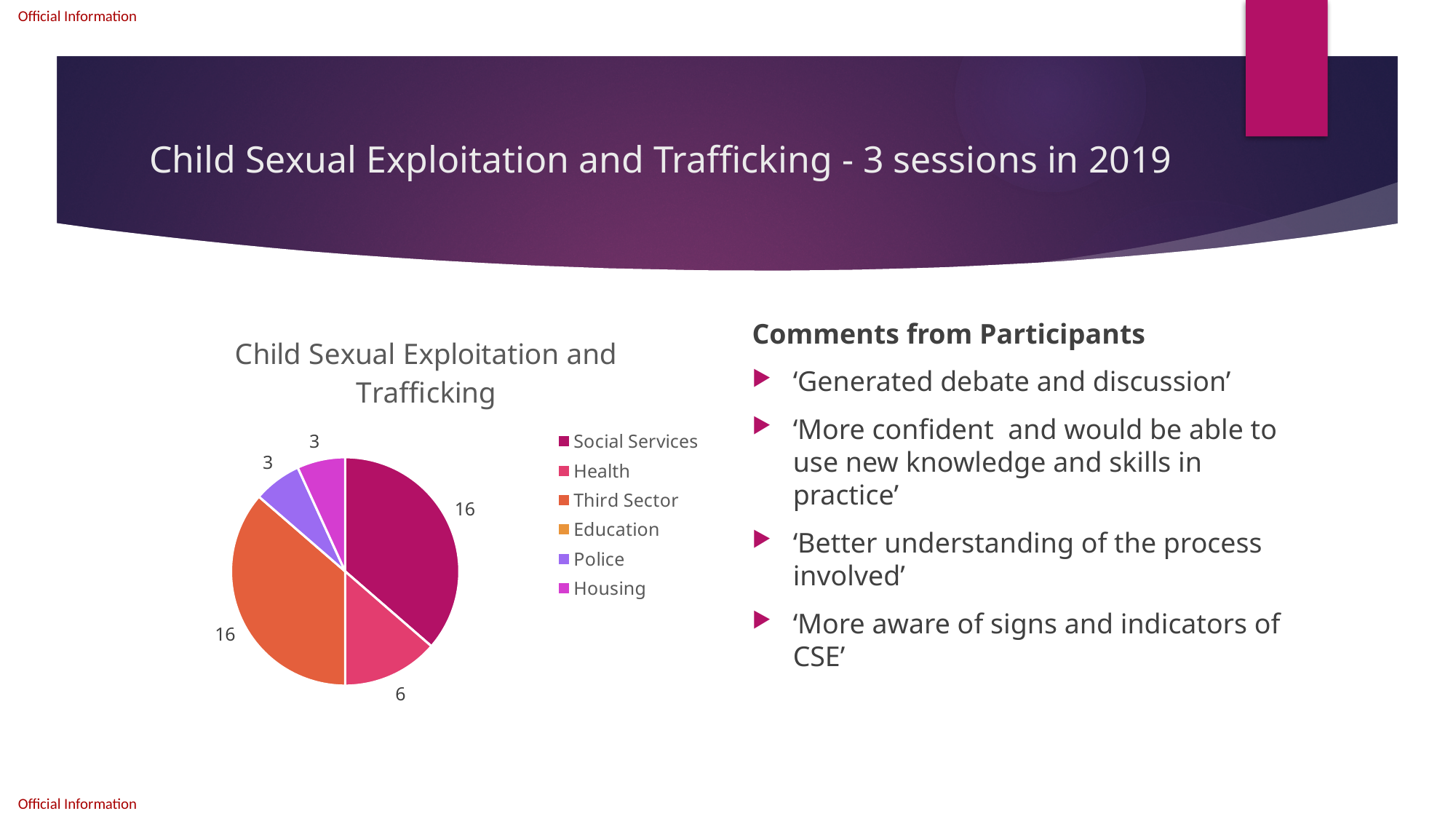
How many entries does the legend of the pie chart list? 6 What kind of chart is shown on the slide? pie chart What is the title of the pie chart? Child Sexual Exploitation and Trafficking What is the value for Health in the pie chart? 6 What is the value for Housing in the pie chart? 3 What is the value for Police in the pie chart? 3 What is the value for Third Sector in the pie chart? 16 Which is larger, the value for Social Services or the value for Health? Social Services What is the difference between the values for Third Sector and Police? 13 What is the value for Social Services in the pie chart? 16 Which is larger, the value for Health or the value for Housing? Health What is the difference between the values for Social Services and Health? 10